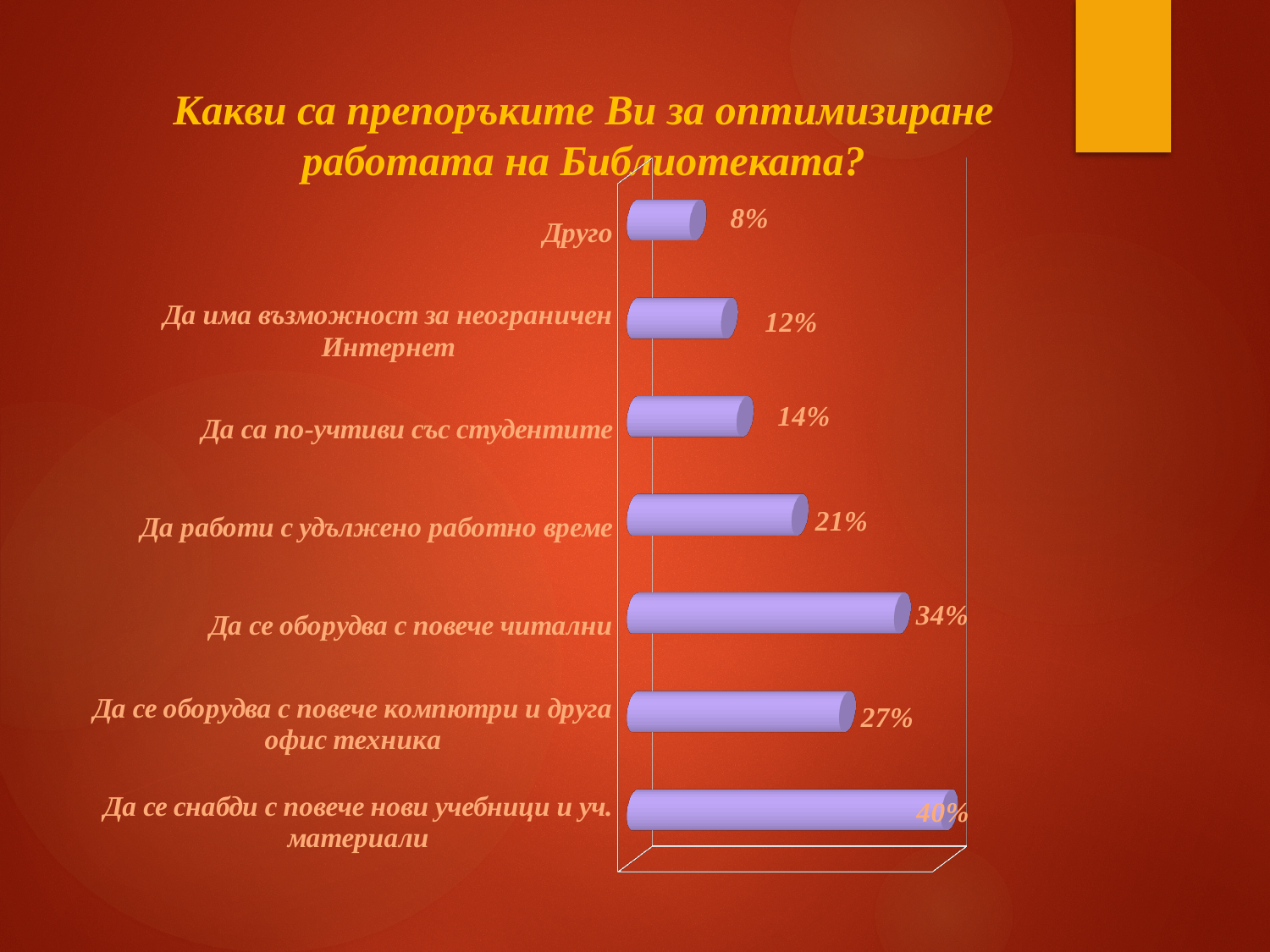
What percentage is shown for "Да се снабди с повече нови учебници и уч. материали"? 40% What percentage is shown for "Друго"? 8% What is the difference between the highest and lowest values in the chart? 32% How many categories are shown in the chart? 7 What is the title of the slide above the chart? Какви са препоръките Ви за оптимизиране работата на Библиотеката? Which category has the lowest value? Друго What is the difference between the values for "Да се оборудва с повече читални" and "Да се оборудва с повече компютри и друга офис техника"? 7% What percentage is shown for "Да работи с удължено работно време"? 21% What percentage is shown for "Да се оборудва с повече читални"? 34% Which category has the highest value? Да се снабди с повече нови учебници и уч. материали Which is larger: the value for "Да са по-учтиви със студентите" or the value for "Да има възможност за неограничен Интернет"? Да са по-учтиви със студентите What kind of chart is shown on the slide? Bar chart